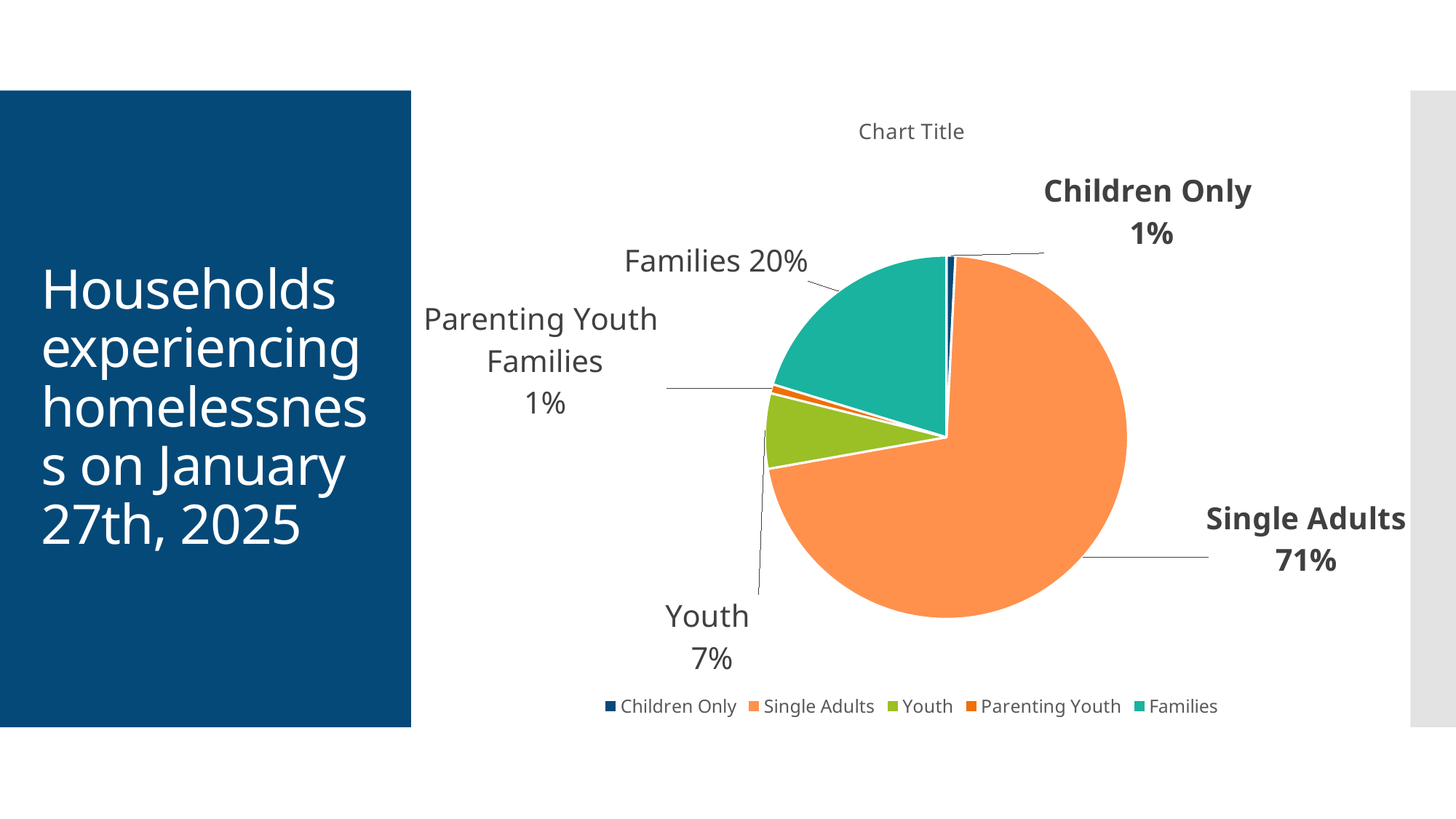
Which category has the largest slice of the pie? Single Adults Which is larger, the Families slice or the Youth slice? Families What colour is the Single Adults slice? orange What share of the pie is Youth? 7% What share of the pie is Parenting Youth Families? 1% What share of the pie is Single Adults? 71% How many categories does the legend list? 5 What is the difference in percentage points between Families and Youth? 13 What kind of chart is shown on the slide? pie chart What is the difference in percentage points between Single Adults and Families? 51